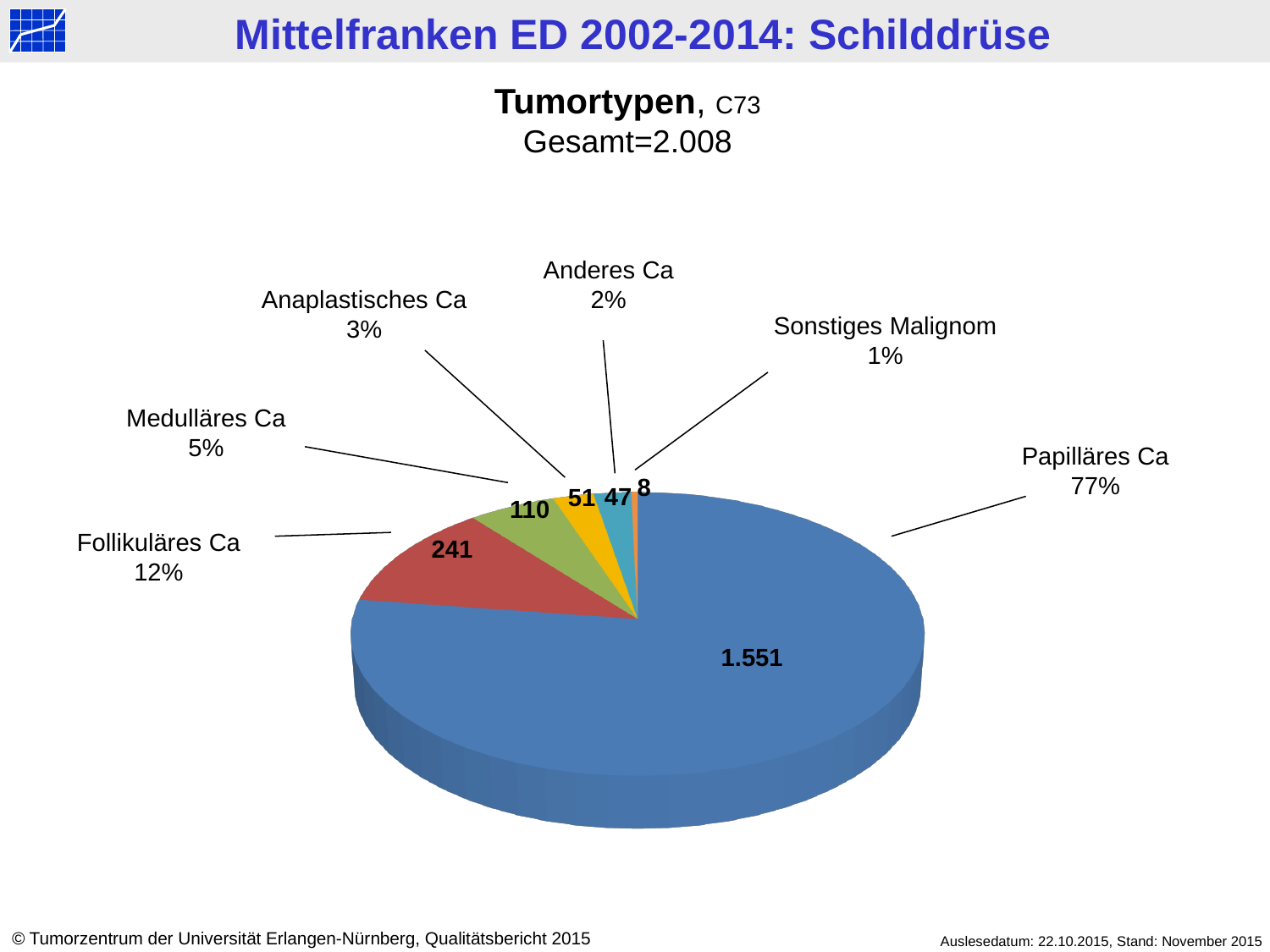
What share of the pie does Anaplastisches Ca represent? 3% Which category has the smallest slice? Sonstiges Malignom What share of the pie does Papilläres Ca represent? 77% What kind of chart is shown on the slide? pie chart What is the value for Sonstiges Malignom? 8 Which category has the largest slice? Papilläres Ca What is the value for Follikuläres Ca? 241 What total (Gesamt) is stated above the chart? 2.008 What is the value for Medulläres Ca? 110 What is the value for Papilläres Ca? 1.551 What is the difference between the values for Follikuläres Ca and Medulläres Ca? 131 How many slices does the pie chart have? 6